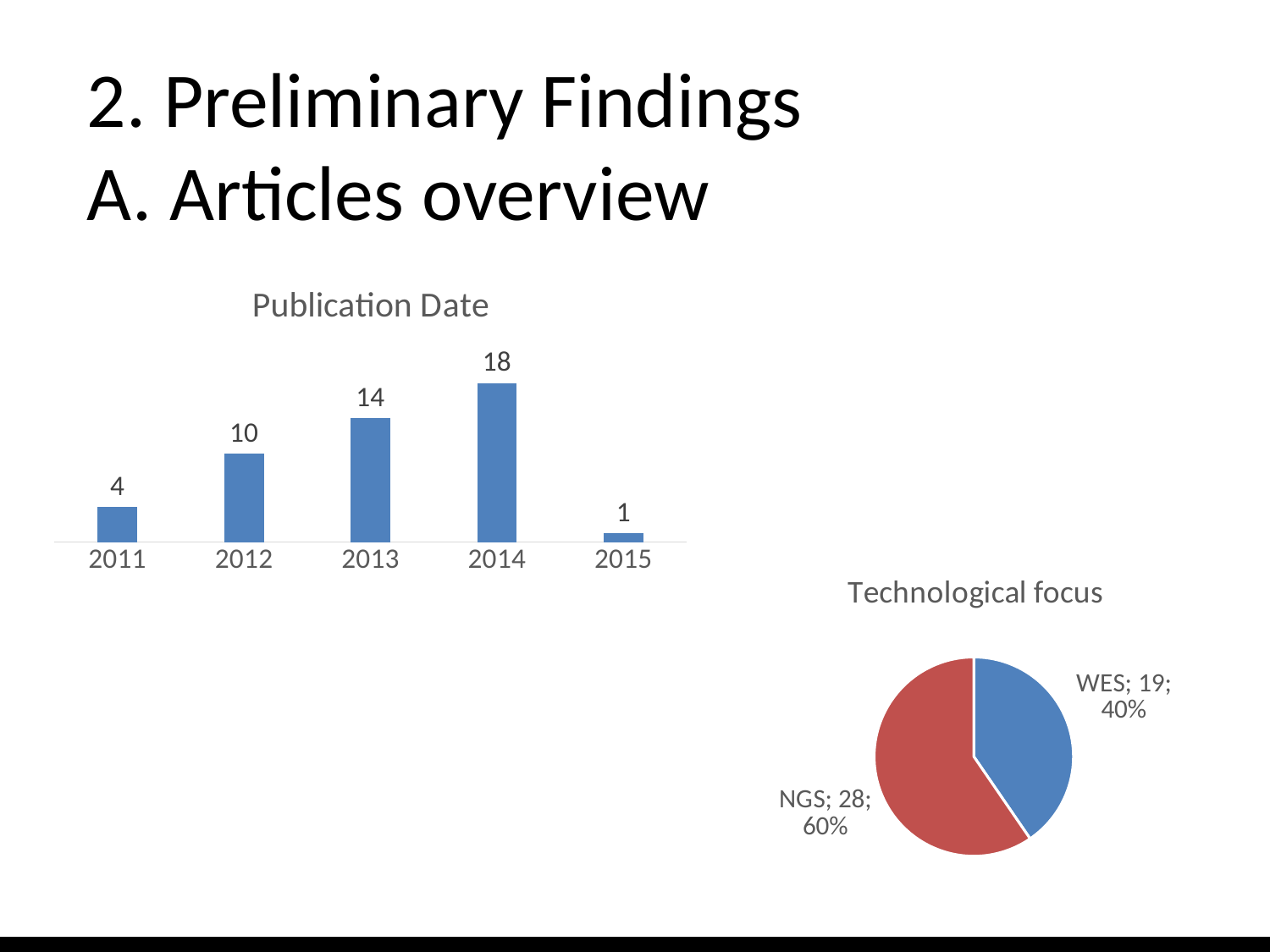
In the Technological focus chart, what is the value for NGS? 28 In the Publication Date chart, what is the difference between the values for 2014 and 2012? 8 In the Publication Date chart, do the values rise or fall from 2011 to 2014? rise What kind of chart is the Publication Date chart? bar chart In the Technological focus chart, what share of the pie does WES represent? 40% In the Publication Date chart, which year has the lowest value? 2015 In the Publication Date chart, which year has the highest value? 2014 In the Publication Date chart, which is larger, the value for 2012 or the value for 2013? 2013 In the Publication Date chart, what is the value for 2011? 4 In the Publication Date chart, what is the value for 2013? 14 How many years are shown in the Publication Date chart? 5 What kind of chart is the Technological focus chart? pie chart